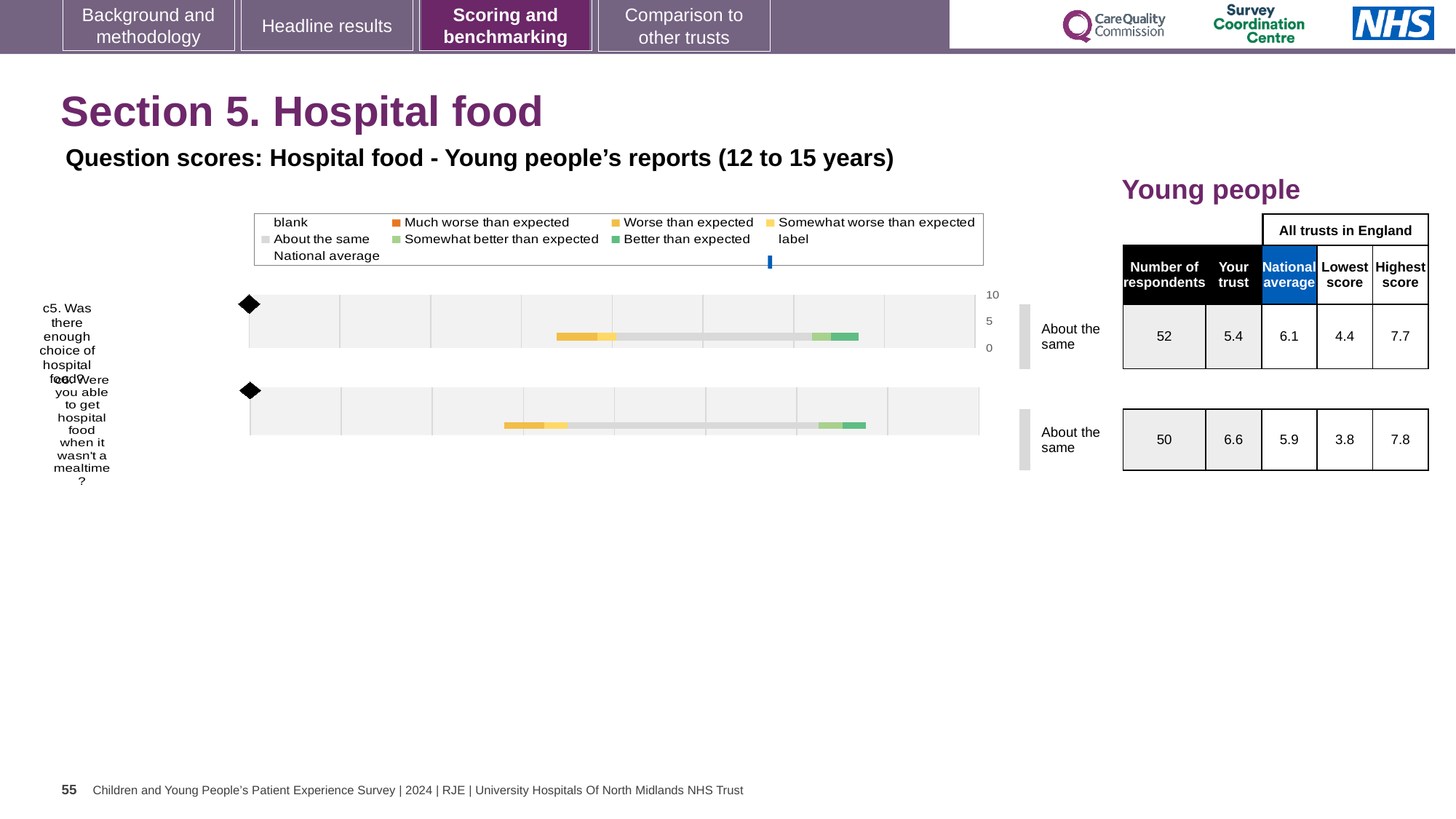
What is the national average score for question c6? 5.9 What is the subtitle describing the question scores shown on the slide? Question scores: Hospital food - Young people's reports (12 to 15 years) How many survey questions are plotted in the hospital food chart? 2 What is the maximum value shown on the score axis of the chart? 10 How many respondents answered question c5 about choice of hospital food? 52 What is the 'Your trust' score for c6 'Were you able to get hospital food when it wasn't a mealtime?' 6.6 What is the 'Your trust' score for c5 'Was there enough choice of hospital food?' 5.4 How much higher is the trust's score than the national average for question c6? 0.7 Which question has the higher 'Your trust' score, c5 or c6? c6 What benchmark rating is given for question c5? About the same What is the difference between the highest score and the lowest score across all trusts for question c5? 3.3 What kind of chart is used to show the question scores for hospital food? bar chart